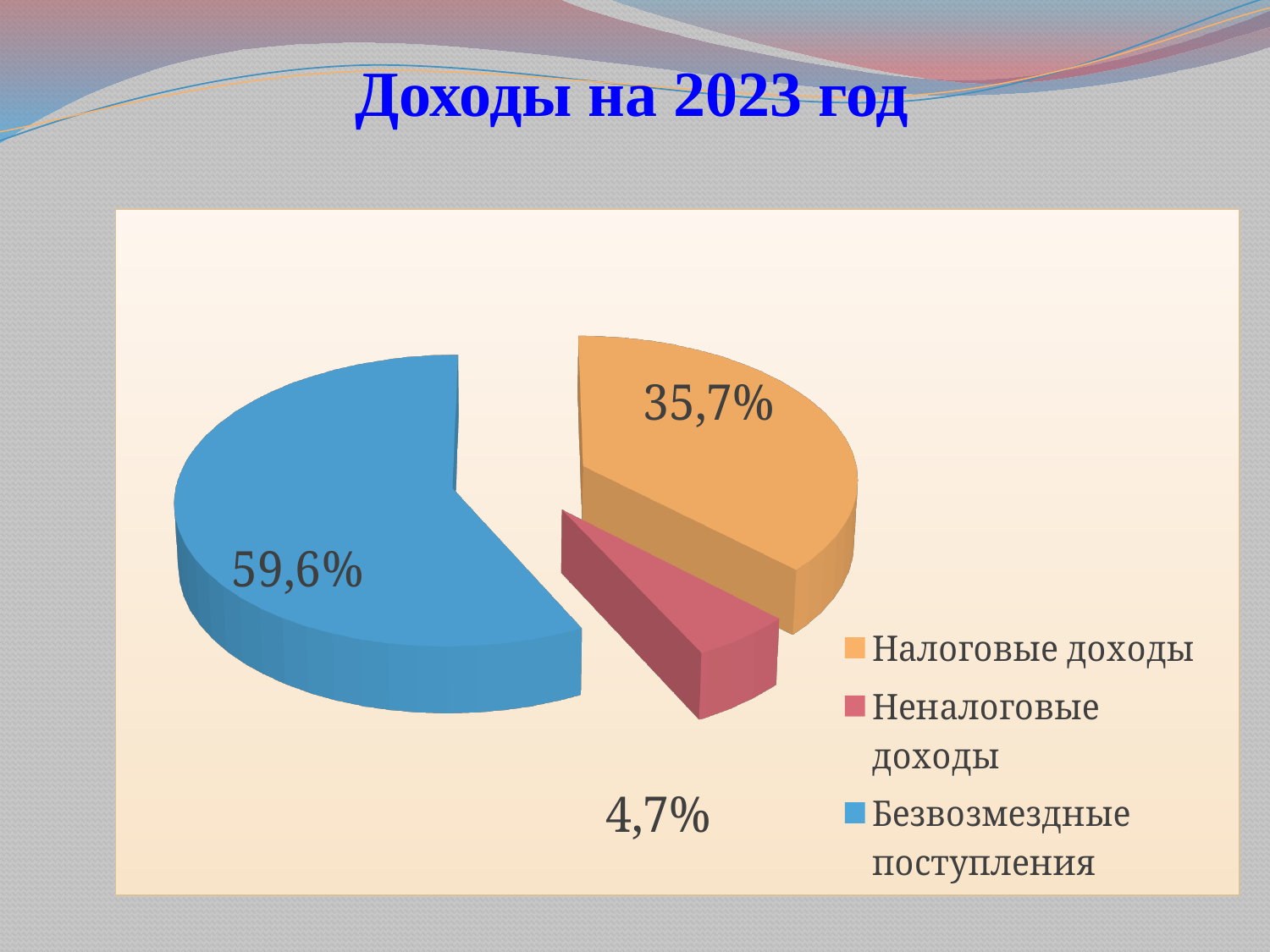
Which is larger, the share of Налоговые доходы or the share of Неналоговые доходы? Налоговые доходы What is the title of the slide? Доходы на 2023 год What share of the pie is Налоговые доходы? 35,7% What share of the pie is Неналоговые доходы? 4,7% What is the difference between the shares of Безвозмездные поступления and Налоговые доходы? 23,9% Which category has the smallest slice of the pie? Неналоговые доходы What kind of chart is shown on the slide? Pie chart What is the difference between the shares of Налоговые доходы and Неналоговые доходы? 31,0% What share of the pie is Безвозмездные поступления? 59,6% What colour is the slice for Безвозмездные поступления? Blue Which category has the largest slice of the pie? Безвозмездные поступления How many categories does the pie chart show? 3